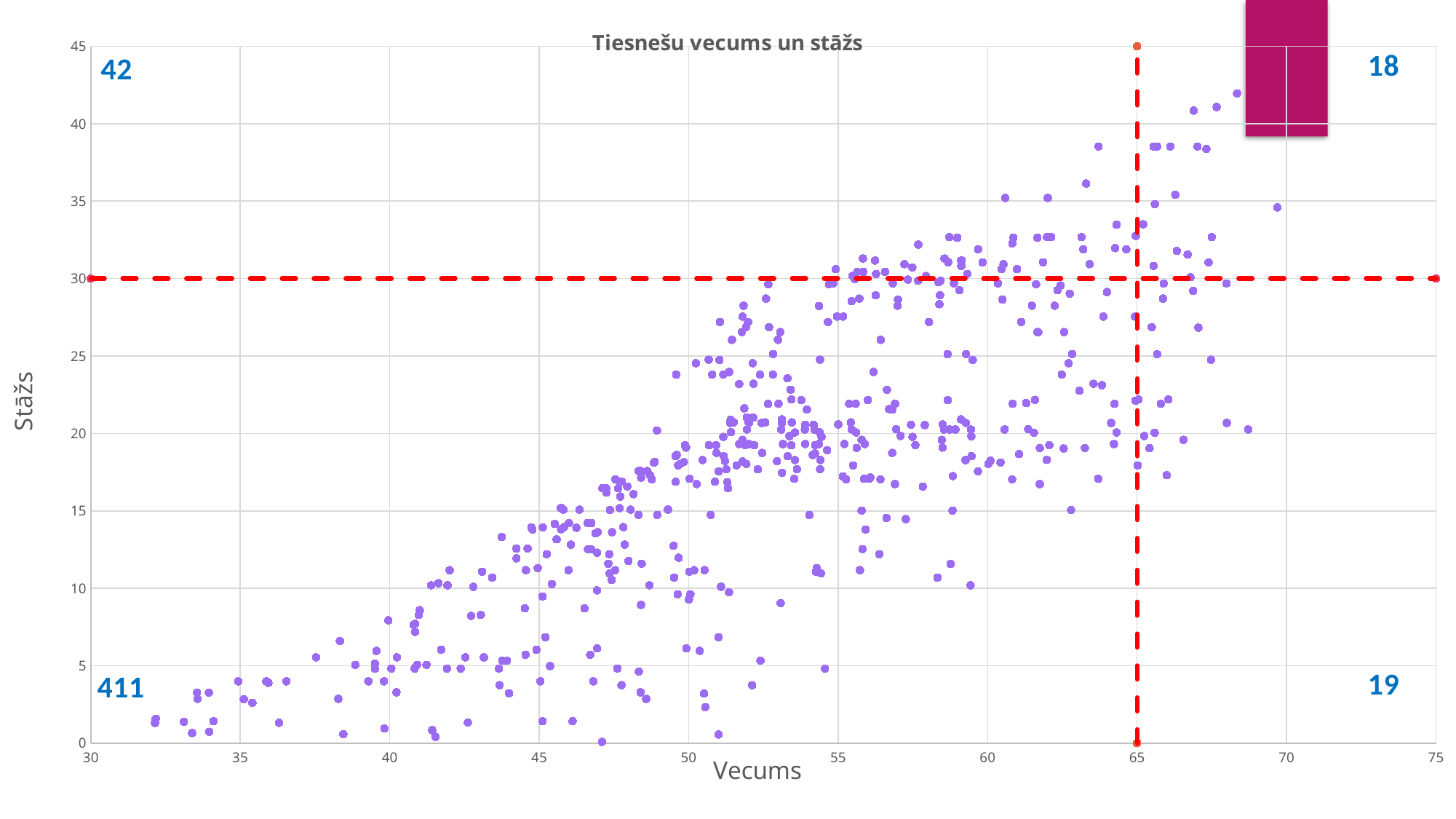
Which quadrant has the largest printed count? bottom-left (411) What number is printed in the bottom-left quadrant of the chart? 411 Do the Stāžs values generally rise or fall as Vecums increases along the x axis? rise What kind of chart is shown on the slide? scatter plot What is the label of the x axis? Vecums What is the title of the chart? Tiesnešu vecums un stāžs What is the total of the four quadrant counts printed on the chart? 490 What number is printed in the top-right quadrant of the chart? 18 Which quadrant has the smallest printed count? top-right (18) What is the difference between the top-left count (42) and the top-right count (18)? 24 What number is printed in the bottom-right quadrant of the chart? 19 What number is printed in the top-left quadrant of the chart? 42